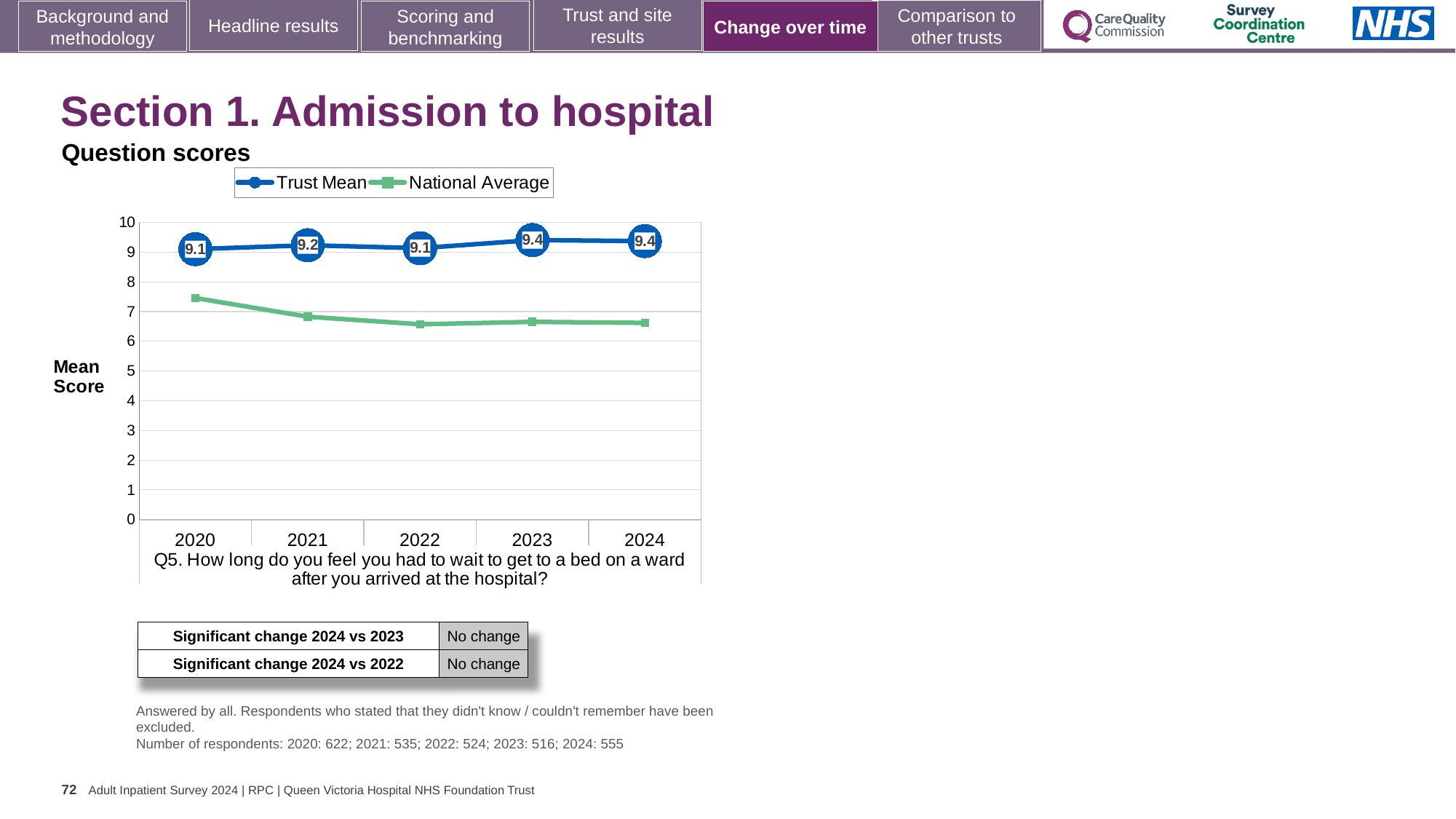
What is the Trust Mean value for 2021? 9.2 What kind of chart is shown on the slide? Line chart Is the National Average value for 2020 greater or less than 7? greater In 2024, which series has the higher value, Trust Mean or National Average? Trust Mean What is the difference between the Trust Mean in 2024 and the Trust Mean in 2020? 0.3 Does the National Average rise or fall from 2020 to 2022? Fall How many series does the chart legend list? 2 What is the Trust Mean value for 2020? 9.1 Is the National Average value for 2022 greater or less than 7? less How many years are plotted on the x axis of the chart? 5 Which is larger, the Trust Mean for 2021 or the Trust Mean for 2022? 2021 What is the Trust Mean value for 2023? 9.4